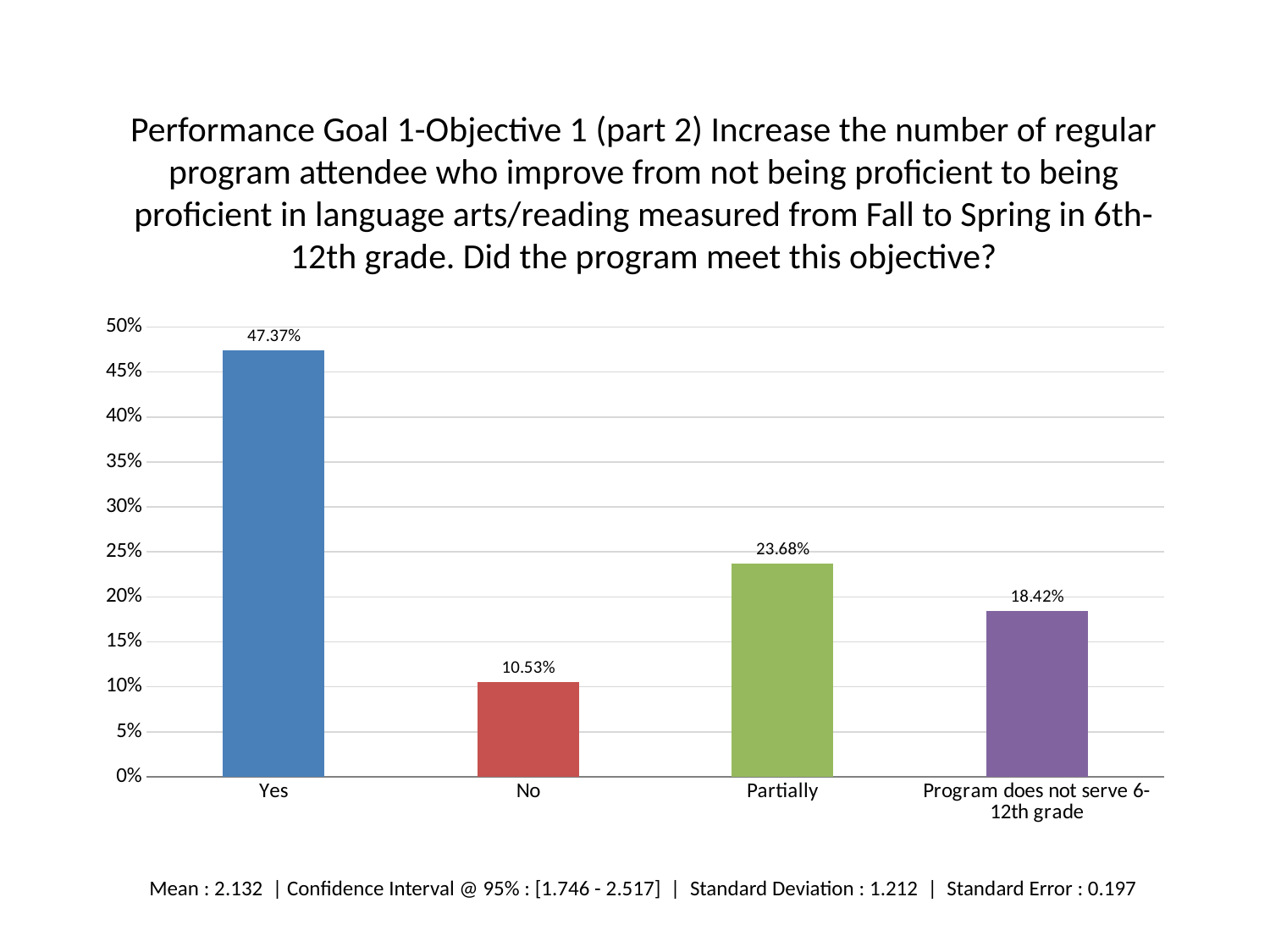
What is the difference between the values for Yes and Partially? 23.69% Is the value for Yes greater or less than 45%? greater Which category has the lowest value? No What mean value is reported in the text below the chart? 2.132 What kind of chart is shown on the slide? bar chart Which category has the highest value? Yes What is the value for Partially? 23.68% What is the value for Yes? 47.37% What is the value for No? 10.53% How many categories are shown on the x axis? 4 Which is larger, the value for Partially or the value for Program does not serve 6-12th grade? Partially What is the value for Program does not serve 6-12th grade? 18.42%